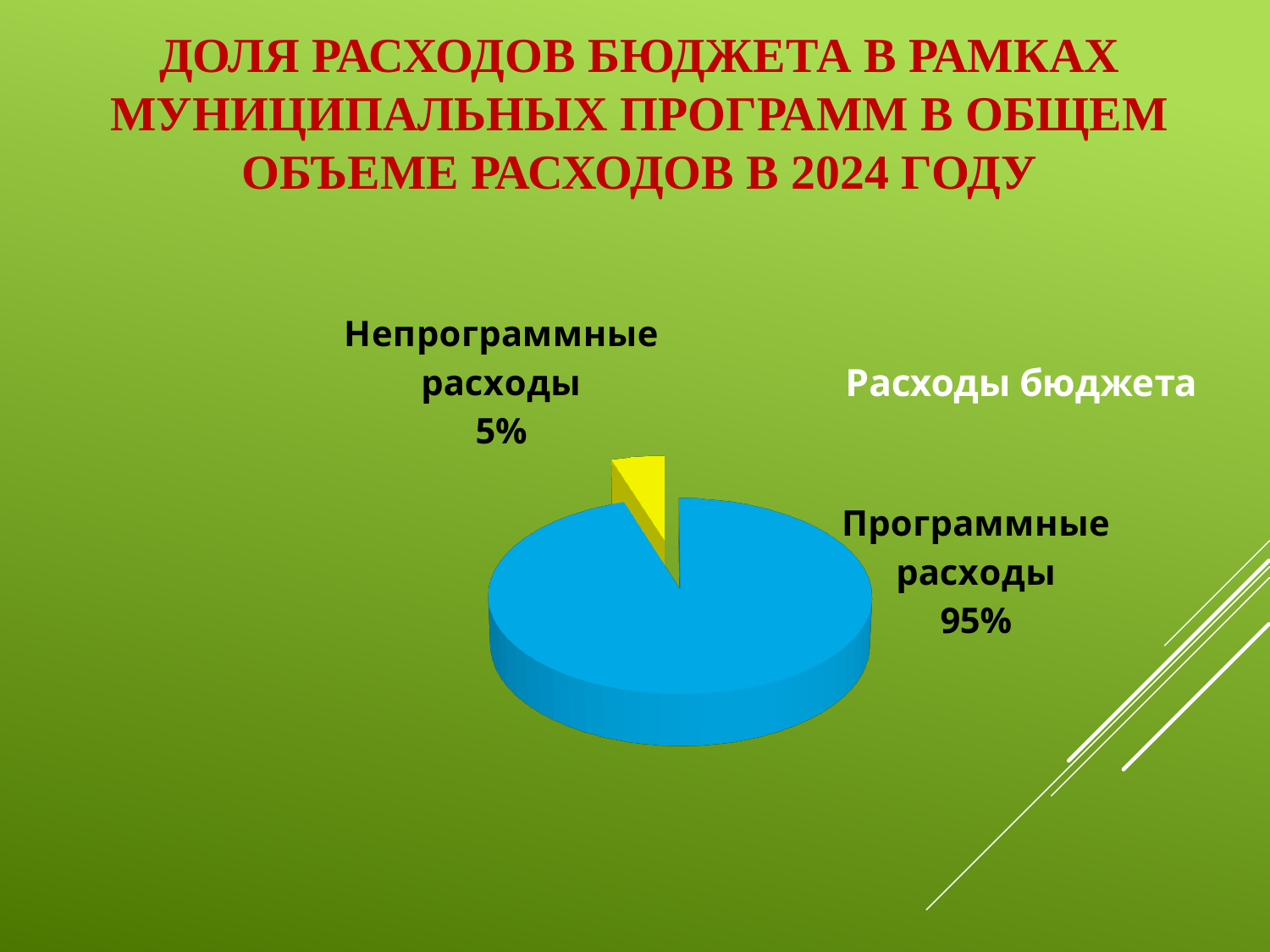
Which slice of the pie is the largest? Программные расходы What kind of chart is shown on the slide? Pie chart What is the difference in percentage points between "Программные расходы" and "Непрограммные расходы"? 90 Which is larger, "Программные расходы" or "Непрограммные расходы"? Программные расходы What share of the pie is labelled "Непрограммные расходы"? 5% What is the title of the pie chart? Расходы бюджета How many slices does the pie chart have? 2 What share of the pie is labelled "Программные расходы"? 95% Which slice of the pie is the smallest? Непрограммные расходы What colour is the slice for "Непрограммные расходы"? Yellow What is the total of the two slice percentages shown? 100%